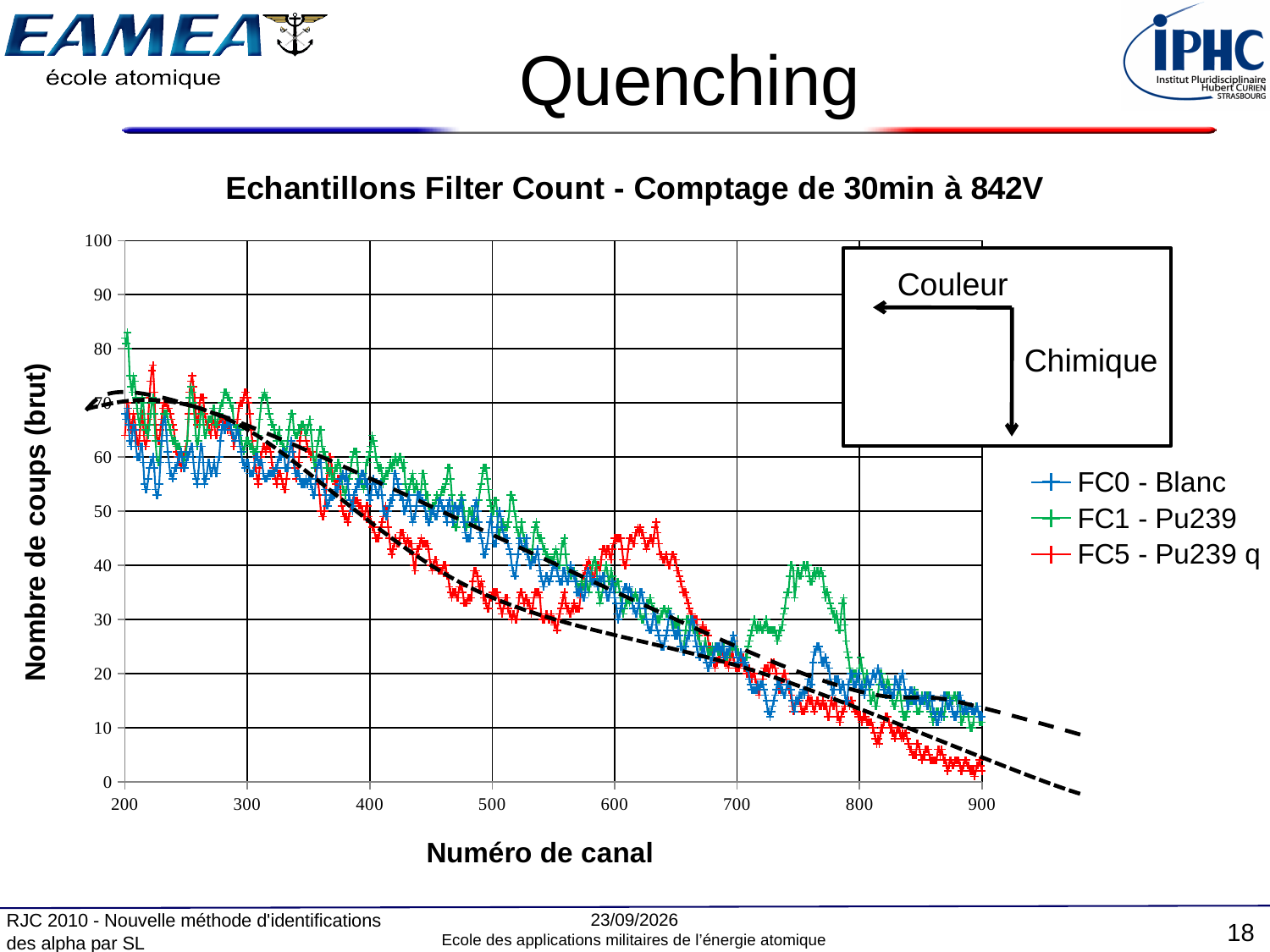
Is the value for FC5 - Pu239 q at channel 500 greater or less than 40? less Is the value for FC5 - Pu239 q at channel 620 greater or less than 40? greater At channel 900, which series has the larger value, FC0 - Blanc or FC5 - Pu239 q? FC0 - Blanc Is the value for FC0 - Blanc at channel 200 greater or less than 50? greater What is the label of the x axis? Numéro de canal Do the values of the FC5 - Pu239 q series generally rise or fall as the channel number increases? fall How many series does the chart legend list? 3 What is the title of the chart? Echantillons Filter Count - Comptage de 30min à 842V Do the values of the FC0 - Blanc series generally rise or fall from channel 200 to channel 900? fall What kind of chart is shown on the slide? line chart